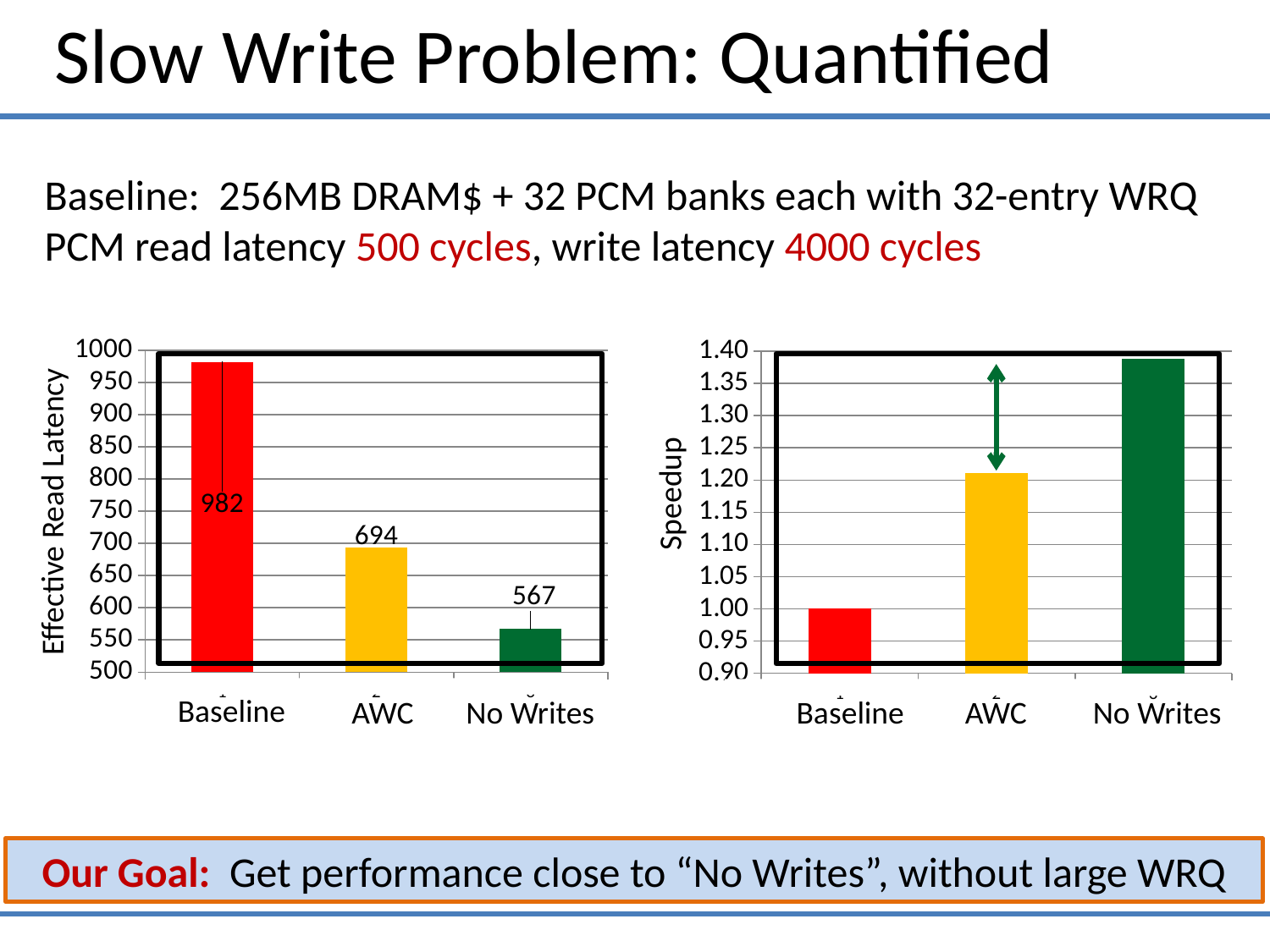
What kind of chart is the Effective Read Latency chart on the left? bar chart How many categories are shown in the Speedup chart on the right? 3 In the Effective Read Latency chart on the left, what is the value for No Writes? 567 In the Effective Read Latency chart on the left, which category has the lowest value? No Writes In the Effective Read Latency chart on the left, which category has the highest value? Baseline In the Speedup chart on the right, which category has the highest value? No Writes In the Effective Read Latency chart on the left, what is the value for AWC? 694 In the Speedup chart on the right, is the value for No Writes greater or less than 1.35? greater In the Effective Read Latency chart on the left, what is the difference between the AWC and No Writes values? 127 In the Effective Read Latency chart on the left, what is the value for Baseline? 982 In the Effective Read Latency chart on the left, what is the difference between the Baseline and AWC values? 288